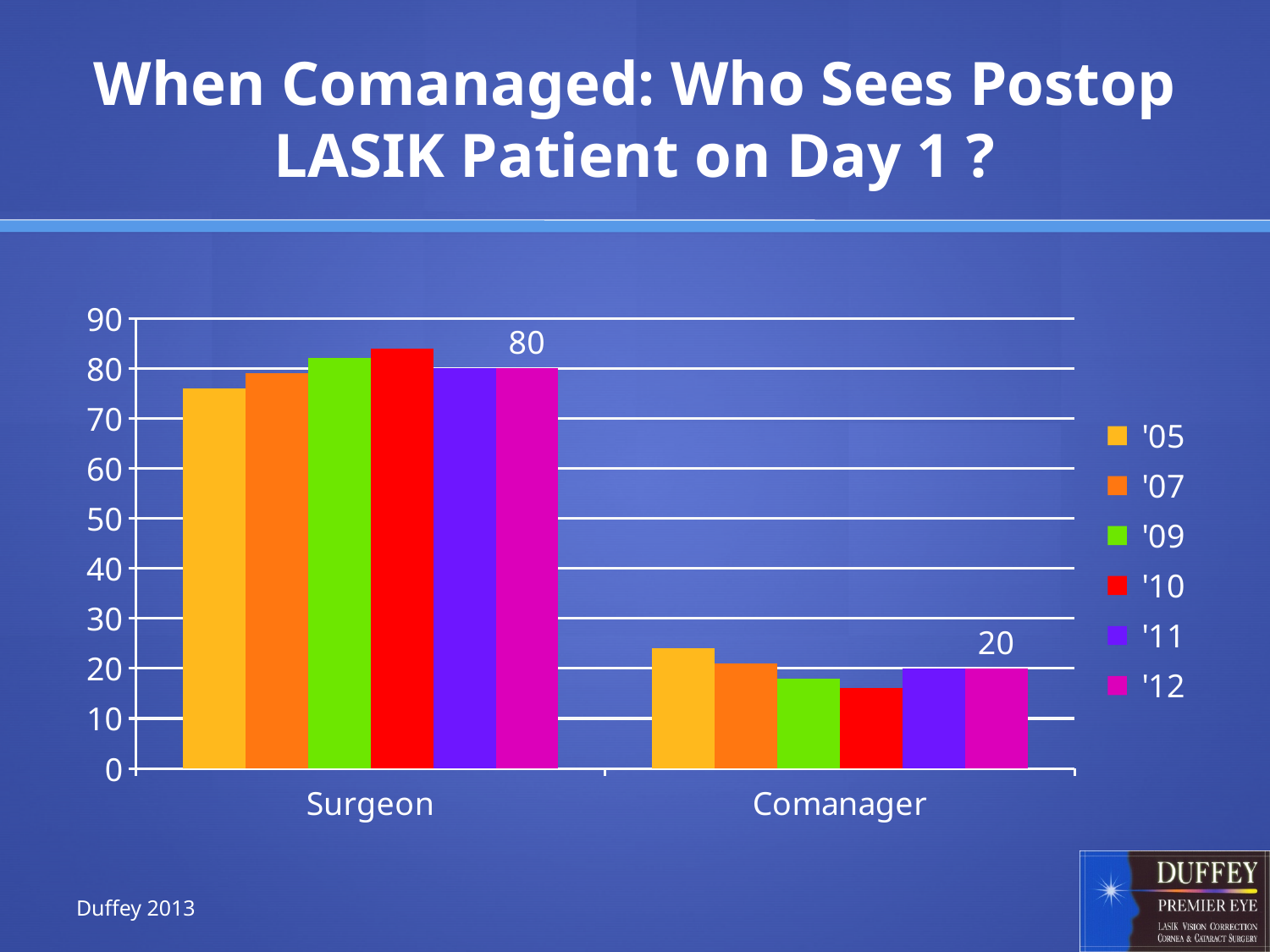
What is the value for '12 in the Surgeon category? 80 Is the value for '10 in the Comanager category greater or less than 20? less Is the value for '10 in the Surgeon category greater or less than 80? greater What is the title of the chart on the slide? When Comanaged: Who Sees Postop LASIK Patient on Day 1 ? Is the value for '05 in the Surgeon category greater or less than 70? greater What is the value for '12 in the Comanager category? 20 Which year has the highest value in the Surgeon category? '10 How many series does the legend list? 6 What kind of chart is shown on the slide? bar chart How many categories are shown on the x axis? 2 What is the difference between the '12 values for Surgeon and Comanager? 60 For the '12 series, which category has the larger value, Surgeon or Comanager? Surgeon